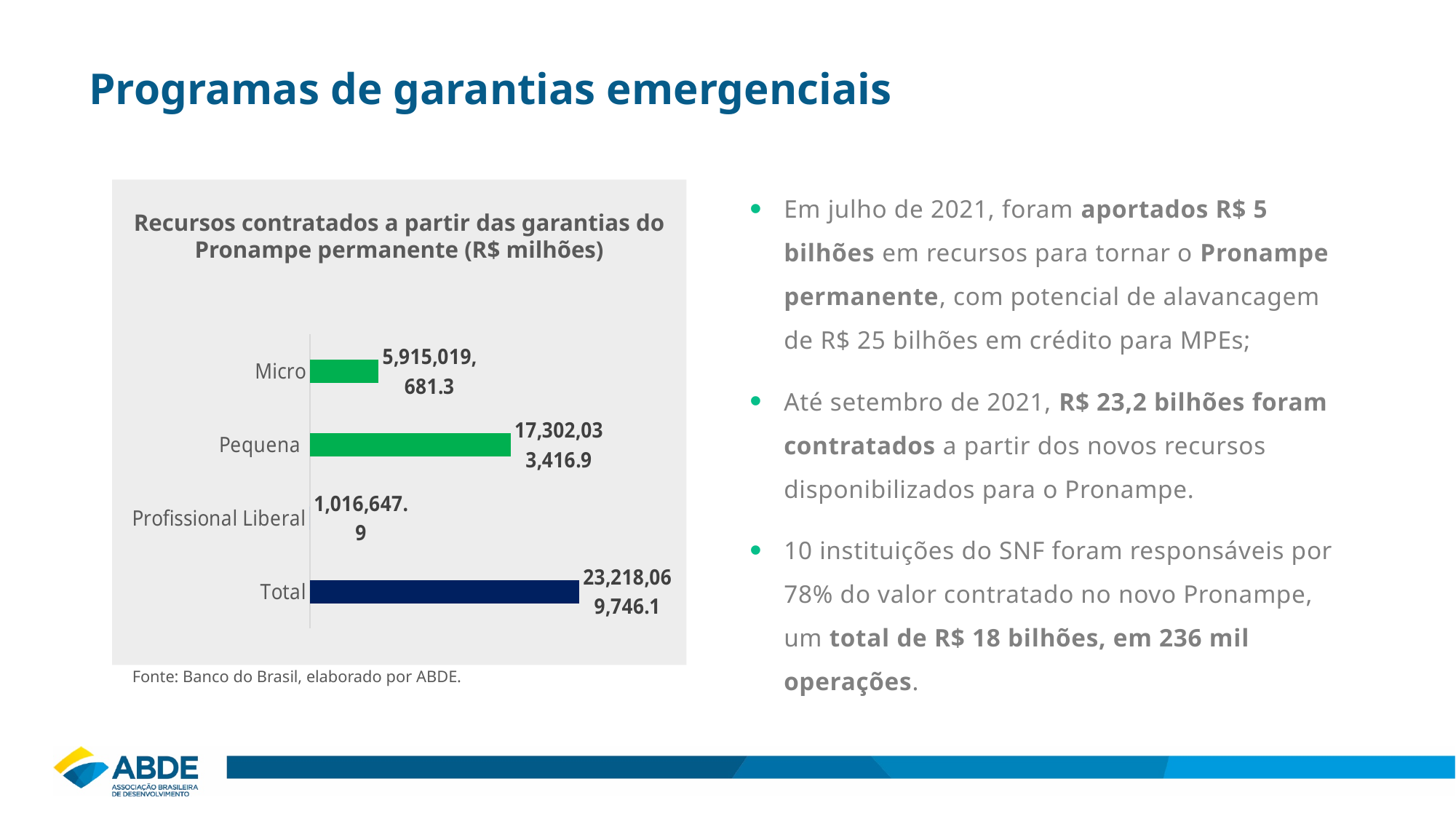
What is the value for Profissional Liberal? 1,016,647.9 Which is larger, the value for Pequena or the value for Micro? Pequena What colour is the Total bar? dark blue What is the title of the chart? Recursos contratados a partir das garantias do Pronampe permanente (R$ milhões) What is the value for Total? 23,218,069,746.1 What is the difference between the values for Pequena and Micro? 11,387,013,735.6 What type of chart is shown on the slide? bar chart What is the value for Micro? 5,915,019,681.3 What is the value for Pequena? 17,302,033,416.9 Excluding the Total bar, which category has the highest value? Pequena How many categories are shown in the chart? 4 Which category has the lowest value? Profissional Liberal